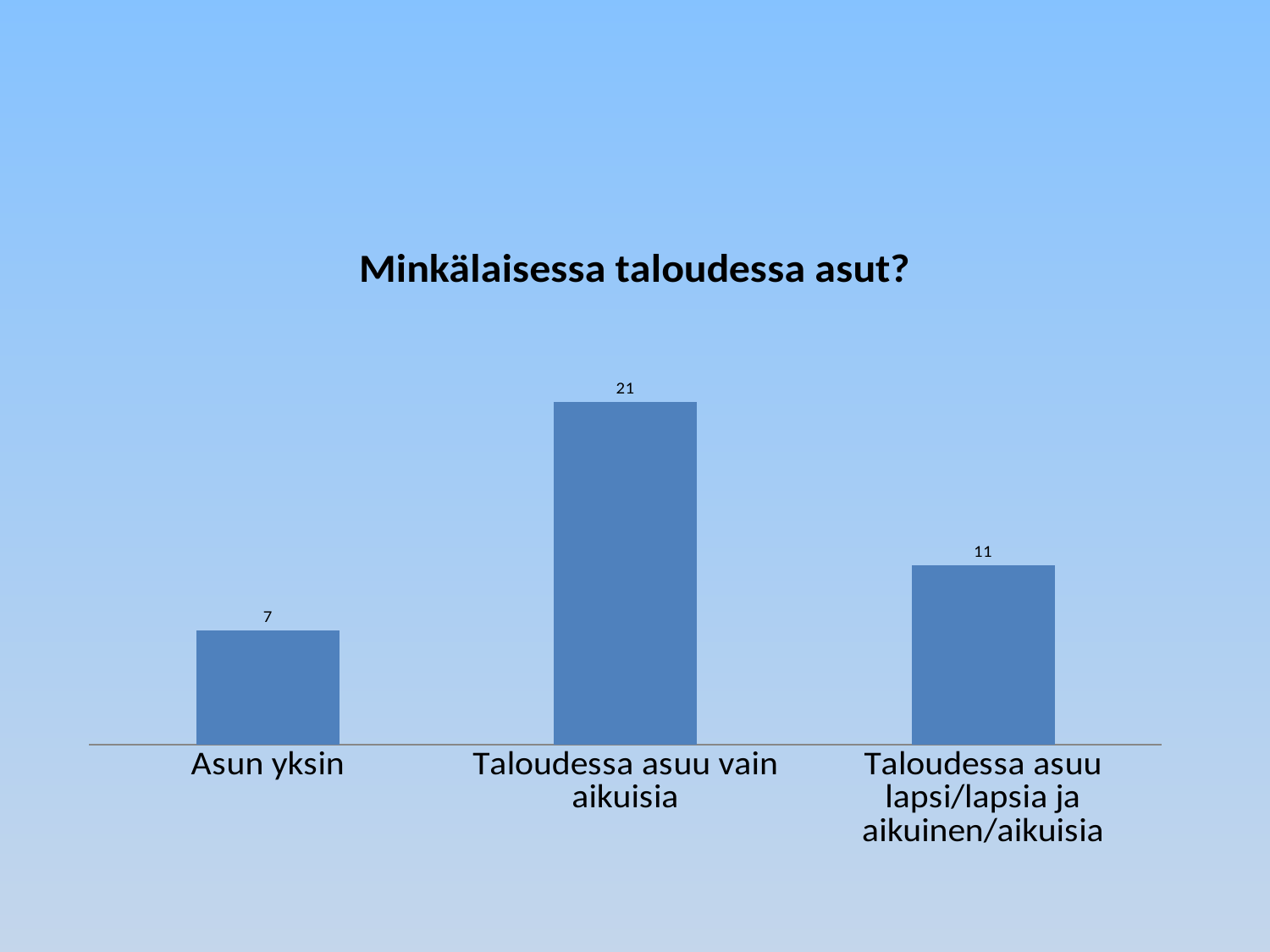
What is the value for "Asun yksin"? 7 What is the value for "Taloudessa asuu lapsi/lapsia ja aikuinen/aikuisia"? 11 What kind of chart is shown on the slide? Bar chart Which is larger, the value for "Taloudessa asuu lapsi/lapsia ja aikuinen/aikuisia" or the value for "Asun yksin"? Taloudessa asuu lapsi/lapsia ja aikuinen/aikuisia What is the value for "Taloudessa asuu vain aikuisia"? 21 What is the title of the chart? Minkälaisessa taloudessa asut? Which category has the lowest value? Asun yksin What is the difference between the values for "Taloudessa asuu vain aikuisia" and "Taloudessa asuu lapsi/lapsia ja aikuinen/aikuisia"? 10 How many categories are shown in the chart? 3 What is the total of the three values shown in the chart? 39 Which category has the highest value? Taloudessa asuu vain aikuisia What is the difference between the values for "Taloudessa asuu vain aikuisia" and "Asun yksin"? 14